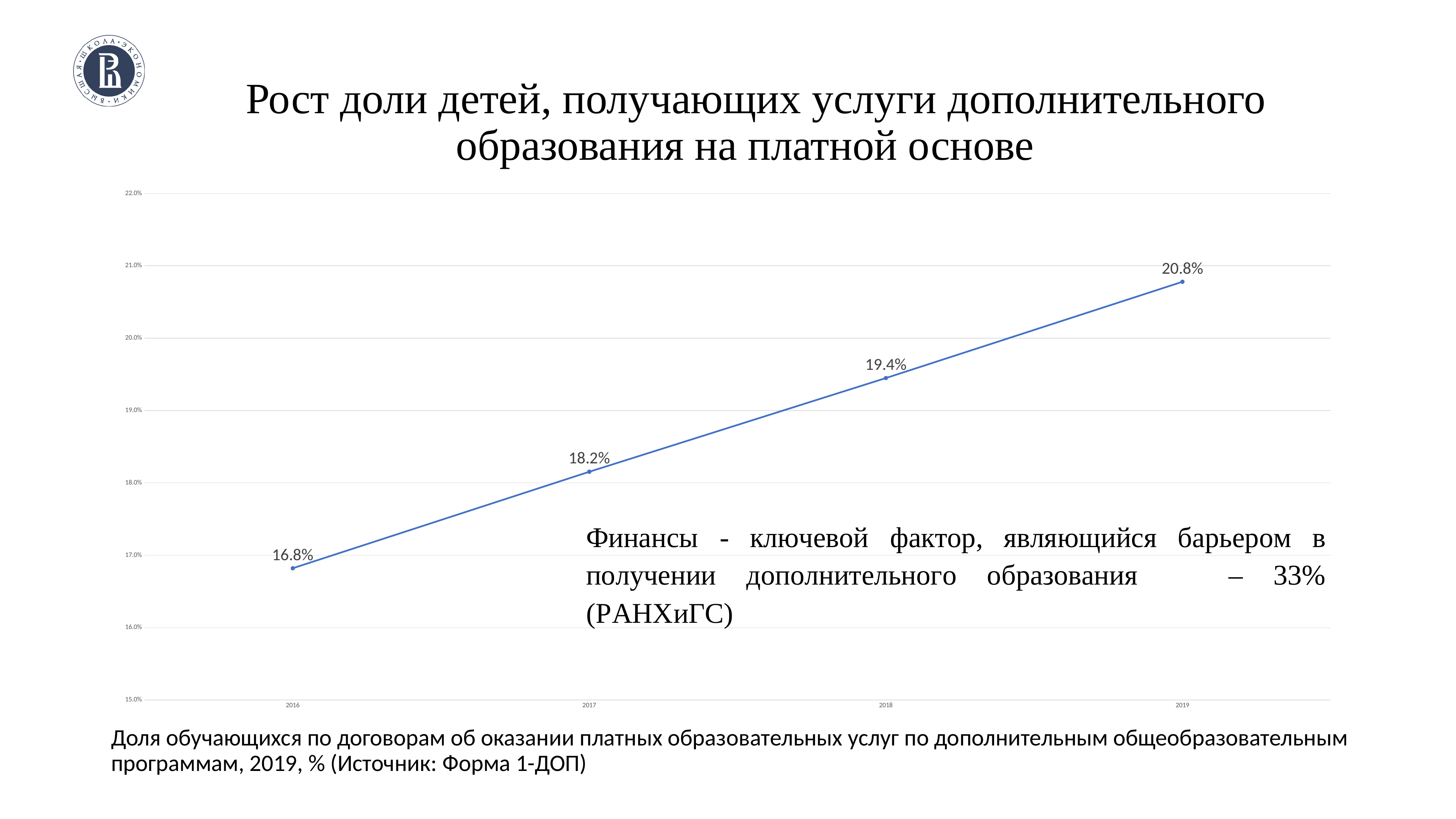
Which is larger, the value for 2017 or the value for 2018? 2018 What kind of chart is shown on the slide? line chart What is the value for 2017? 18.2% Do the values rise or fall from 2016 to 2019? rise How many years are plotted on the chart? 4 Which year has the lowest value? 2016 Which year has the highest value? 2019 What is the value for 2019? 20.8% What is the difference between the values for 2018 and 2017? 1.2% What is the value for 2018? 19.4% What is the value for 2016? 16.8% What is the difference between the values for 2019 and 2016? 4.0%